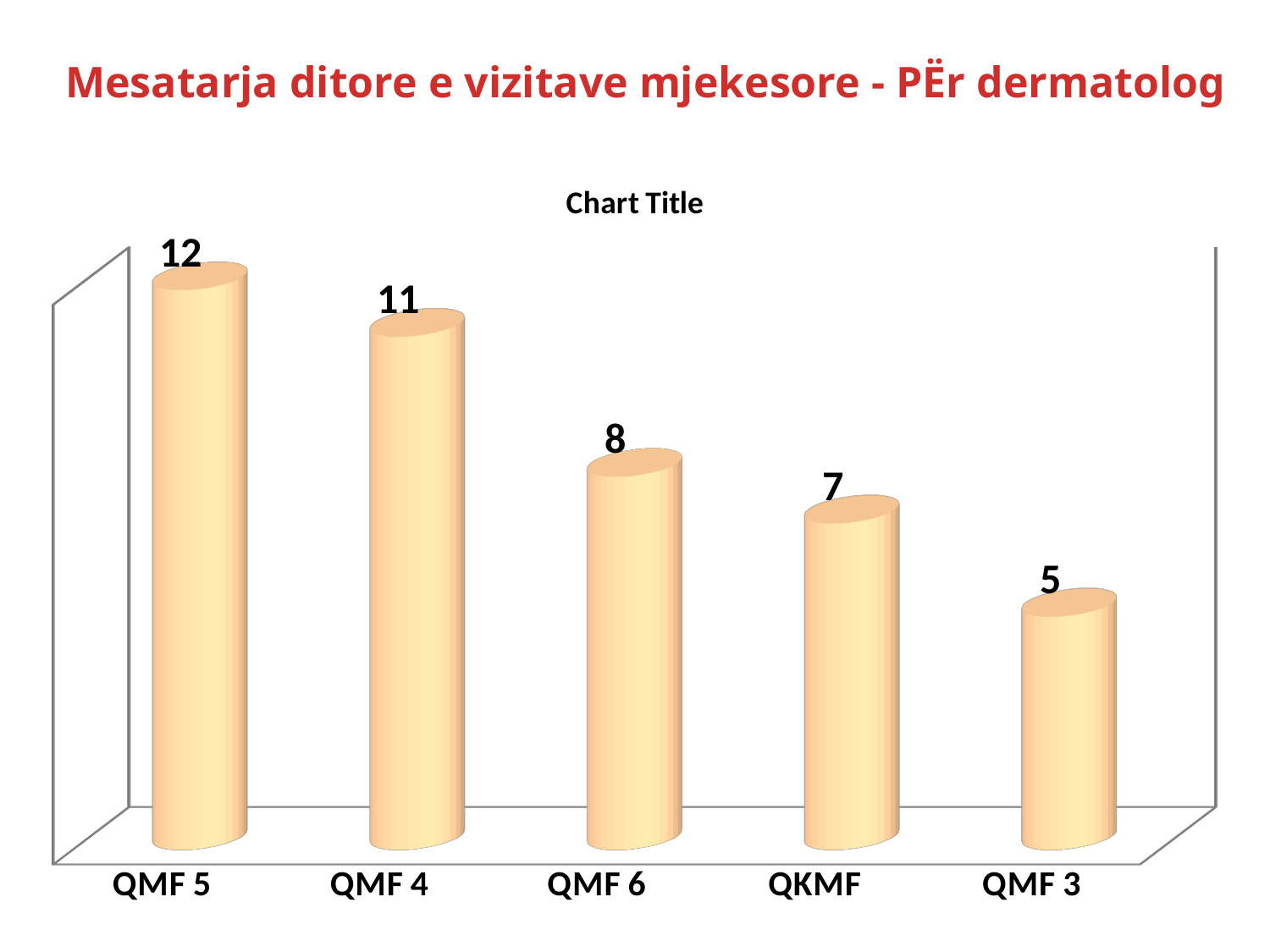
Do the values rise or fall from left to right along the x axis? Fall What is the difference between the values for QMF 5 and QMF 3? 7 Which category has the highest value? QMF 5 What kind of chart is shown on the slide? Bar chart What is the value for QMF 3? 5 What is the value for QMF 6? 8 What is the value for QKMF? 7 Which is larger, the value for QMF 6 or the value for QKMF? QMF 6 Which category has the lowest value? QMF 3 What is the value for QMF 4? 11 How many categories are shown on the chart? 5 What is the value for QMF 5? 12